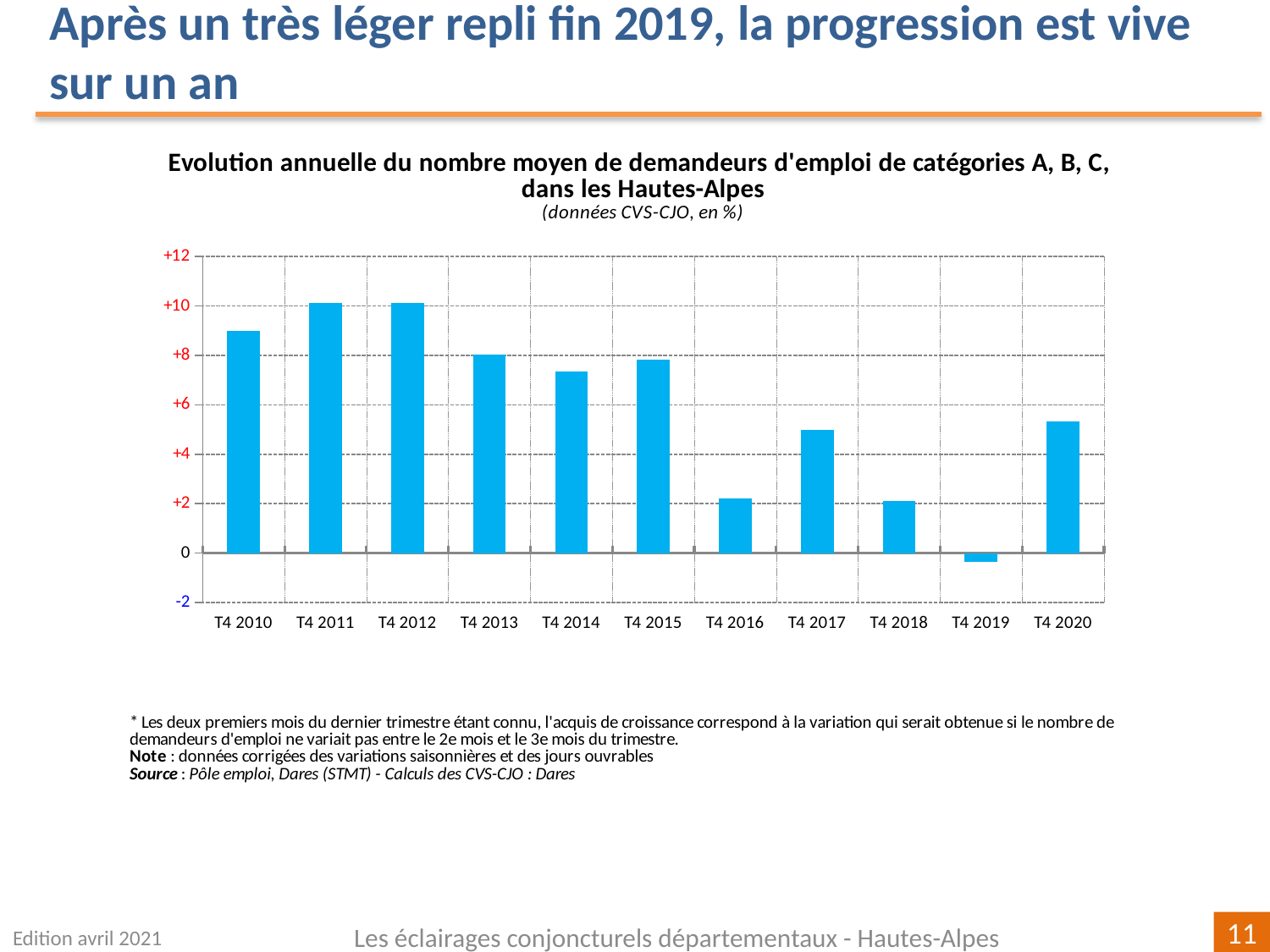
What is the unit of the data indicated under the chart title? % What kind of chart is shown on the slide? bar chart Is the value for T4 2016 greater or less than +4? less Which is larger, the value for T4 2010 or the value for T4 2013? T4 2010 Which quarter has the lowest value? T4 2019 Is the value for T4 2014 greater or less than +8? less From T4 2012 to T4 2014, do the values rise or fall? fall How many quarters (categories) are plotted on the x axis? 11 Is the value for T4 2020 greater or less than +4? greater Which is larger, the value for T4 2017 or the value for T4 2018? T4 2017